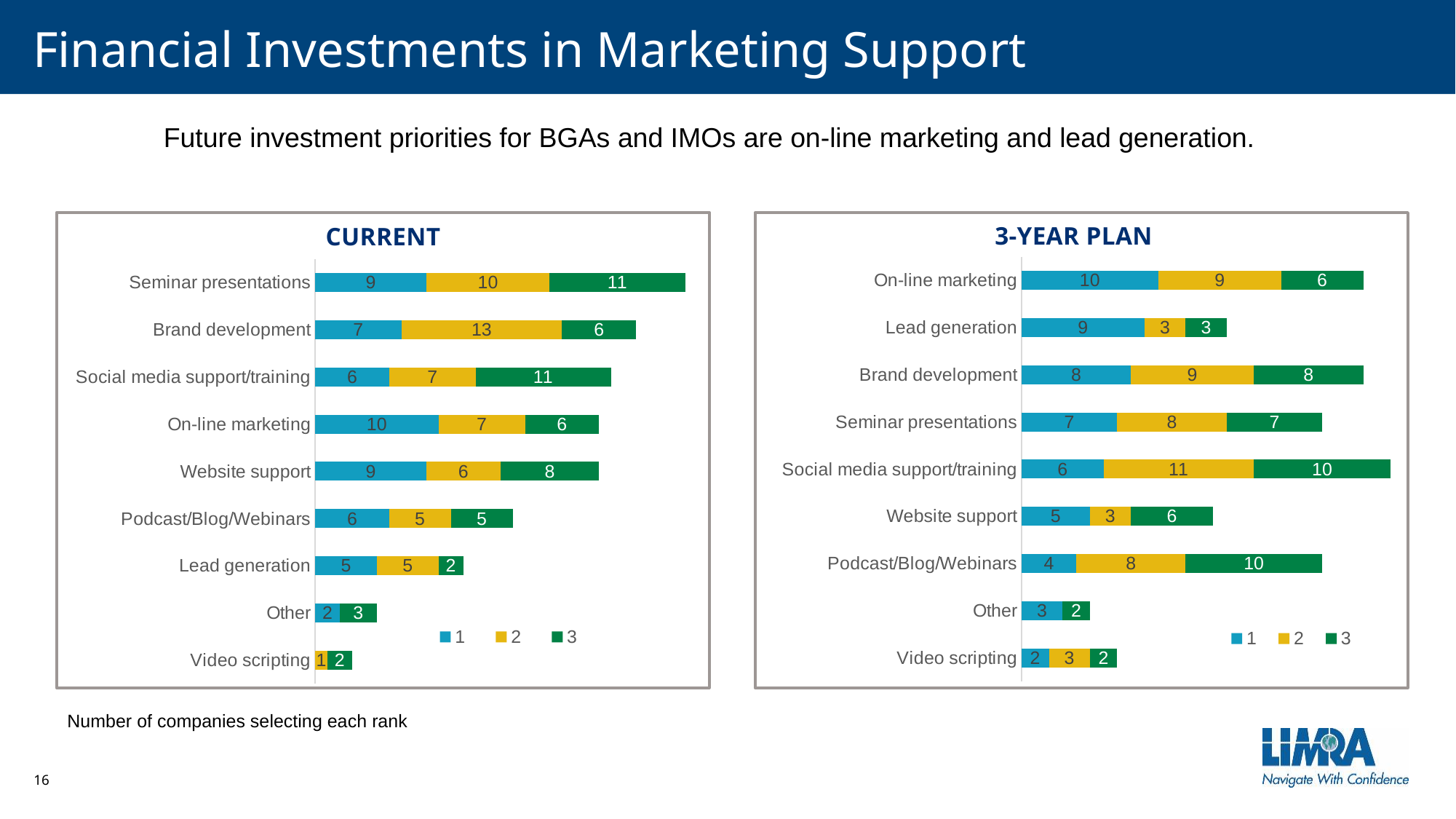
In the CURRENT chart, which has more companies ranking it 1: On-line marketing or Lead generation? On-line marketing In the 3-YEAR PLAN chart, what is the total number of companies across all ranks for Social media support/training? 27 In the 3-YEAR PLAN chart, how many companies ranked Social media support/training as 3? 10 In the CURRENT chart, how many companies ranked Brand development as 2? 13 In the CURRENT chart, which category has the shortest total bar? Video scripting In the CURRENT chart, what is the total number of companies across all ranks for Seminar presentations? 30 How many series does the legend of the CURRENT chart list? 3 How many categories are shown in the 3-YEAR PLAN chart? 9 In the CURRENT chart, which category has the longest total bar? Seminar presentations In the 3-YEAR PLAN chart, what is the difference between the rank 2 and rank 1 counts for Podcast/Blog/Webinars? 4 What type of chart is the 3-YEAR PLAN chart? Stacked bar chart In the 3-YEAR PLAN chart, how many companies ranked Lead generation as 1? 9